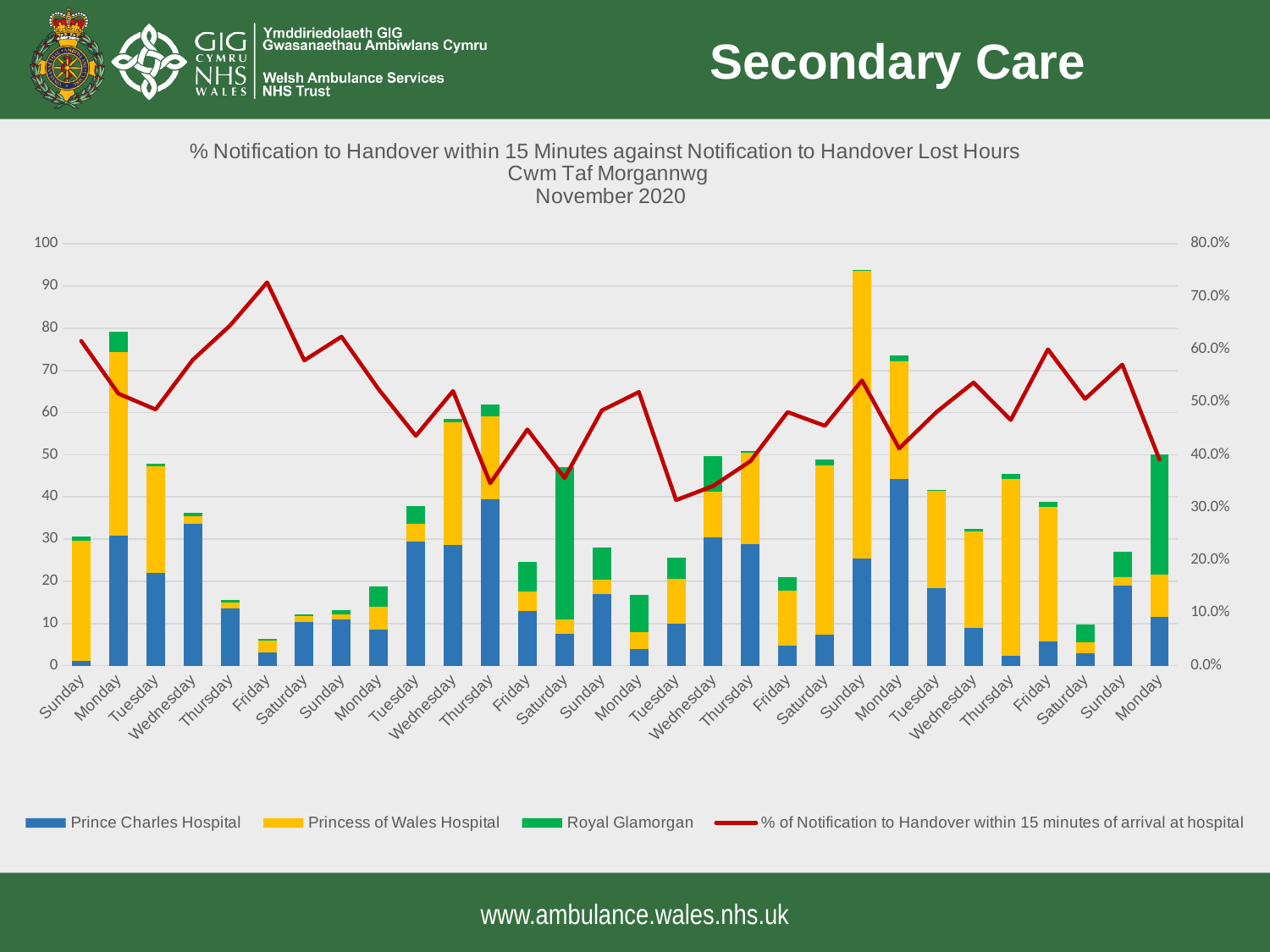
Which day has the tallest stacked bar (highest total lost hours)? The fourth Sunday (22nd bar) Which day has the shortest stacked bar (lowest total lost hours)? The first Friday (6th bar) Is the total stacked bar for the fourth Sunday (22nd bar) greater or less than 90? greater Between the last Sunday and the last Monday, does the red line rise or fall? Fall How many daily bars are plotted along the x axis? 30 On which day does the red line (% of Notification to Handover within 15 minutes) reach its highest point? The first Friday (6th bar) Is the red line value for the third Tuesday (17th bar) greater or less than 40.0%? less Is the total stacked bar for the first Monday (2nd bar) greater or less than 70? greater What kind of chart is shown on the slide? A combined stacked bar and line chart Which colour represents Royal Glamorgan in the stacked bars? Green How many entries does the legend list? 4 Which health board and month does the chart title refer to? Cwm Taf Morgannwg, November 2020